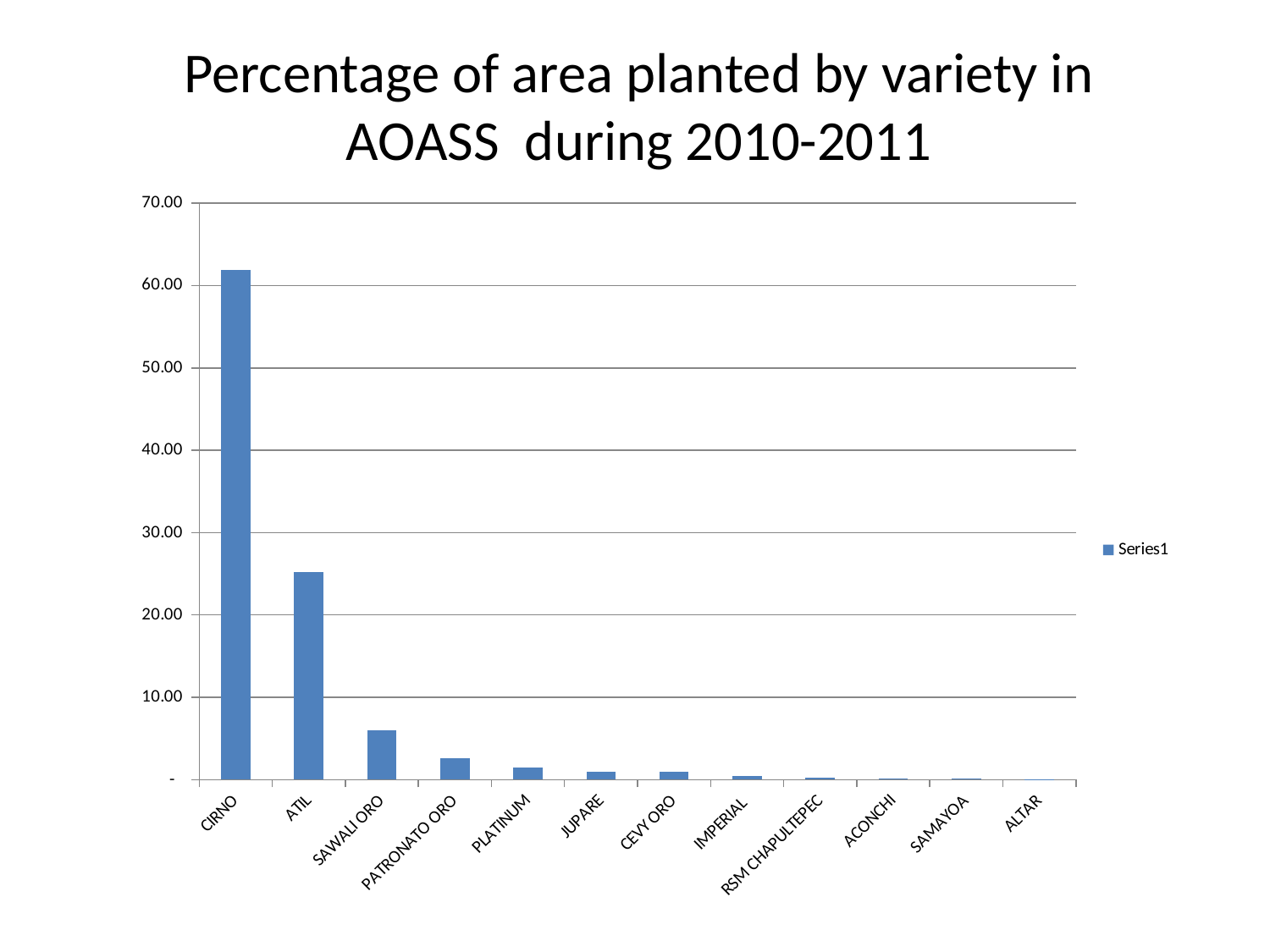
Is the value for CIRNO greater or less than 50.00? greater What kind of chart is shown on the slide? Bar chart How many series does the legend list? 1 How many varieties are shown on the x axis of the chart? 12 Which has a larger percentage of area planted, SAWALI ORO or PLATINUM? SAWALI ORO Is the value for SAWALI ORO greater or less than 10.00? less Do the values rise or fall moving from left to right along the x axis? fall Which has a larger percentage of area planted, CIRNO or ATIL? CIRNO Is the value for ATIL greater or less than 30.00? less Which variety has the second-highest percentage of area planted? ATIL What is the name of the series shown in the legend? Series1 Which variety has the highest percentage of area planted? CIRNO